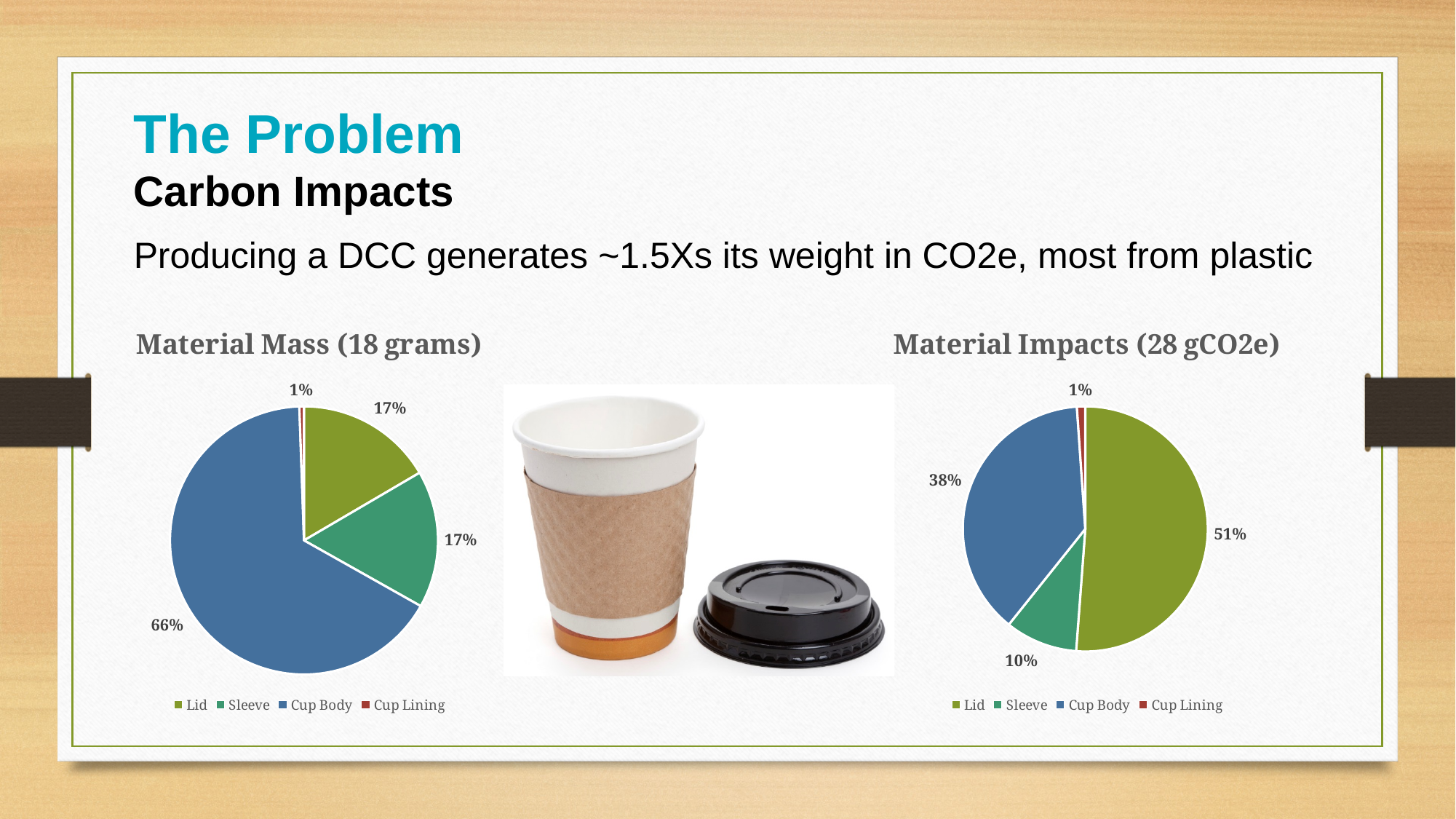
In the Material Impacts (28 gCO2e) chart, what share does Lid have? 51% What type of chart is the Material Mass (18 grams) chart? Pie chart In the Material Mass (18 grams) chart, what colour is the Cup Body slice? Blue In the Material Impacts (28 gCO2e) chart, what share does Sleeve have? 10% In the Material Impacts (28 gCO2e) chart, what share does Cup Body have? 38% In the Material Mass (18 grams) chart, which category has the smallest slice? Cup Lining In the Material Mass (18 grams) chart, which category has the largest slice? Cup Body In the Material Impacts (28 gCO2e) chart, what is the difference between the Lid and Cup Body shares? 13% In the Material Impacts (28 gCO2e) chart, which category has the largest slice? Lid How many categories does the legend of the Material Impacts (28 gCO2e) chart list? 4 In the Material Impacts (28 gCO2e) chart, which is larger, Sleeve or Cup Body? Cup Body